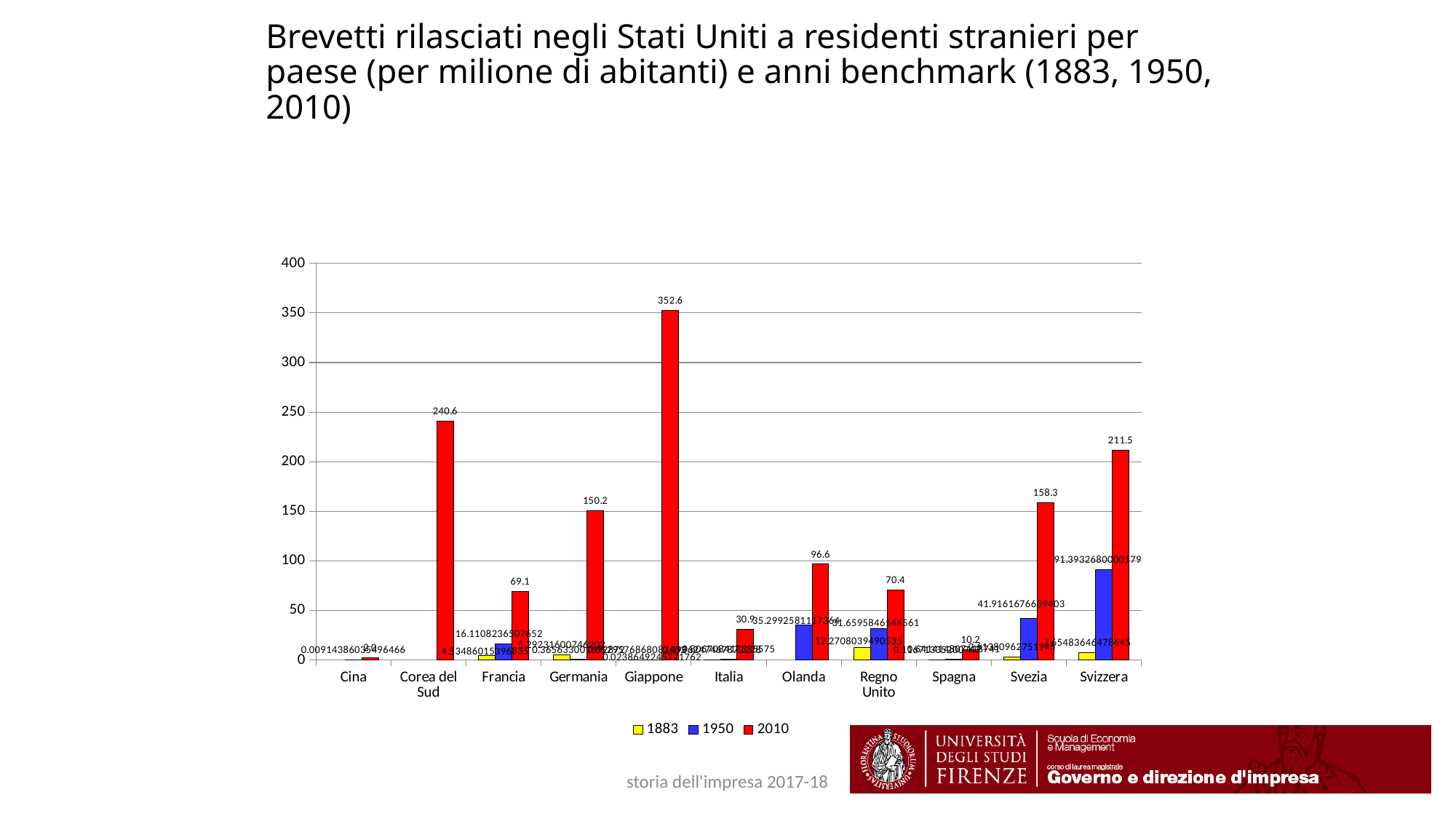
Which colour represents the 2010 series in the legend? red How many countries are shown on the x axis? 11 Which country has the lowest value for 2010? Cina What is the difference between the 2010 values for Giappone and Corea del Sud? 112 What is the value for Regno Unito in 2010? 70.4 What kind of chart is shown on the slide? bar chart What is the value for Svizzera in 2010? 211.5 What is the value for Giappone in 2010? 352.6 Is the value for Svizzera in 1950 greater or less than 100? less Which country has the highest value for 2010? Giappone Which is larger, the 2010 value for Svezia or for Germania? Svezia How many series does the legend list? 3